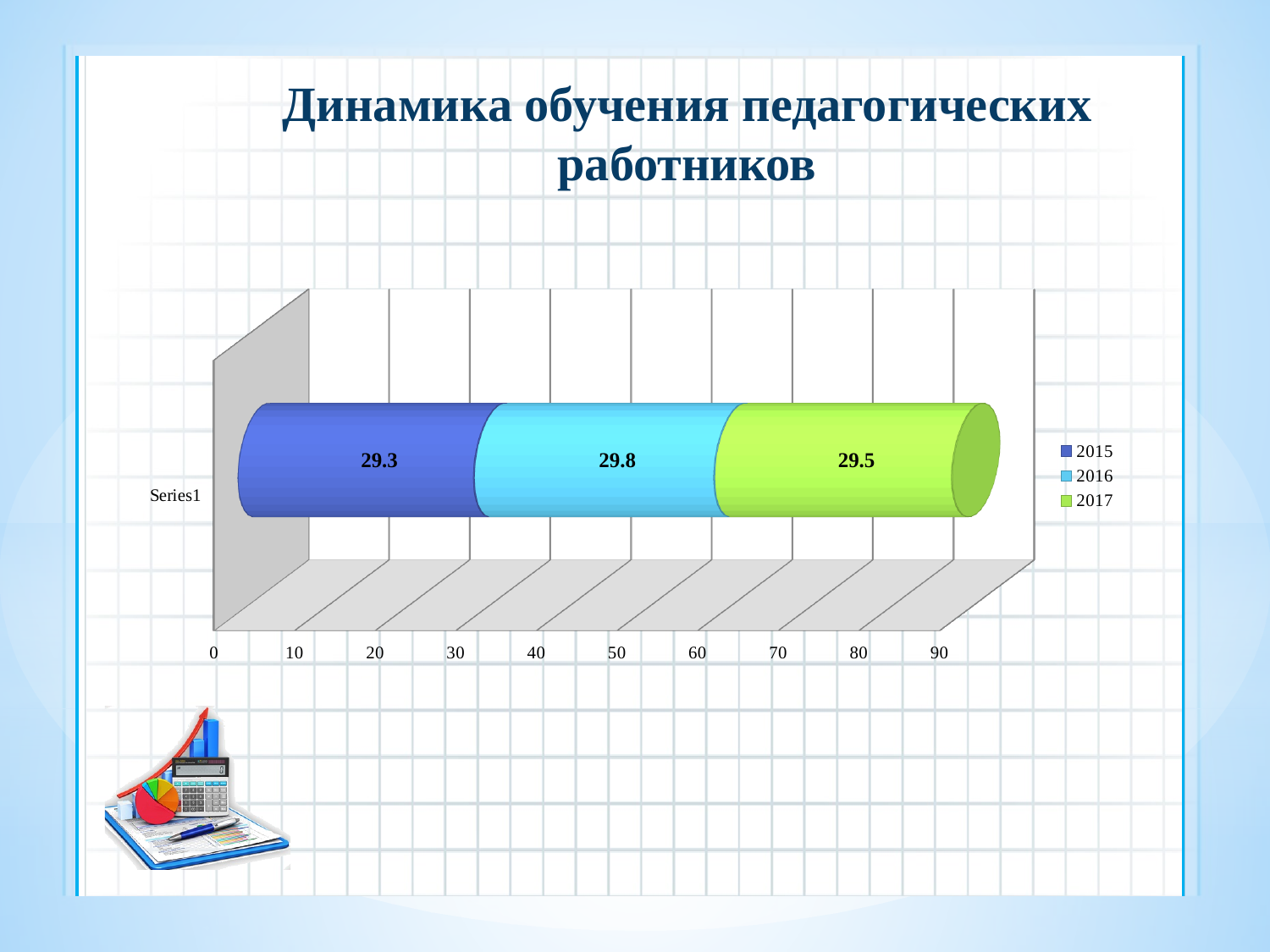
What is the value for 2017 in the stacked bar? 29.5 What is the difference between the values for 2016 and 2017? 0.3 What is the value for 2015 in the stacked bar? 29.3 What is the value for 2016 in the stacked bar? 29.8 What kind of chart is shown on the slide? Stacked bar chart What is the total of the stacked bar for Series1? 88.6 What is the difference between the values for 2016 and 2015? 0.5 How many series does the legend list? 3 What is the title of the chart? Динамика обучения педагогических работников Which year has the highest value? 2016 Which year has the lowest value? 2015 Which is larger, the value for 2017 or the value for 2015? 2017